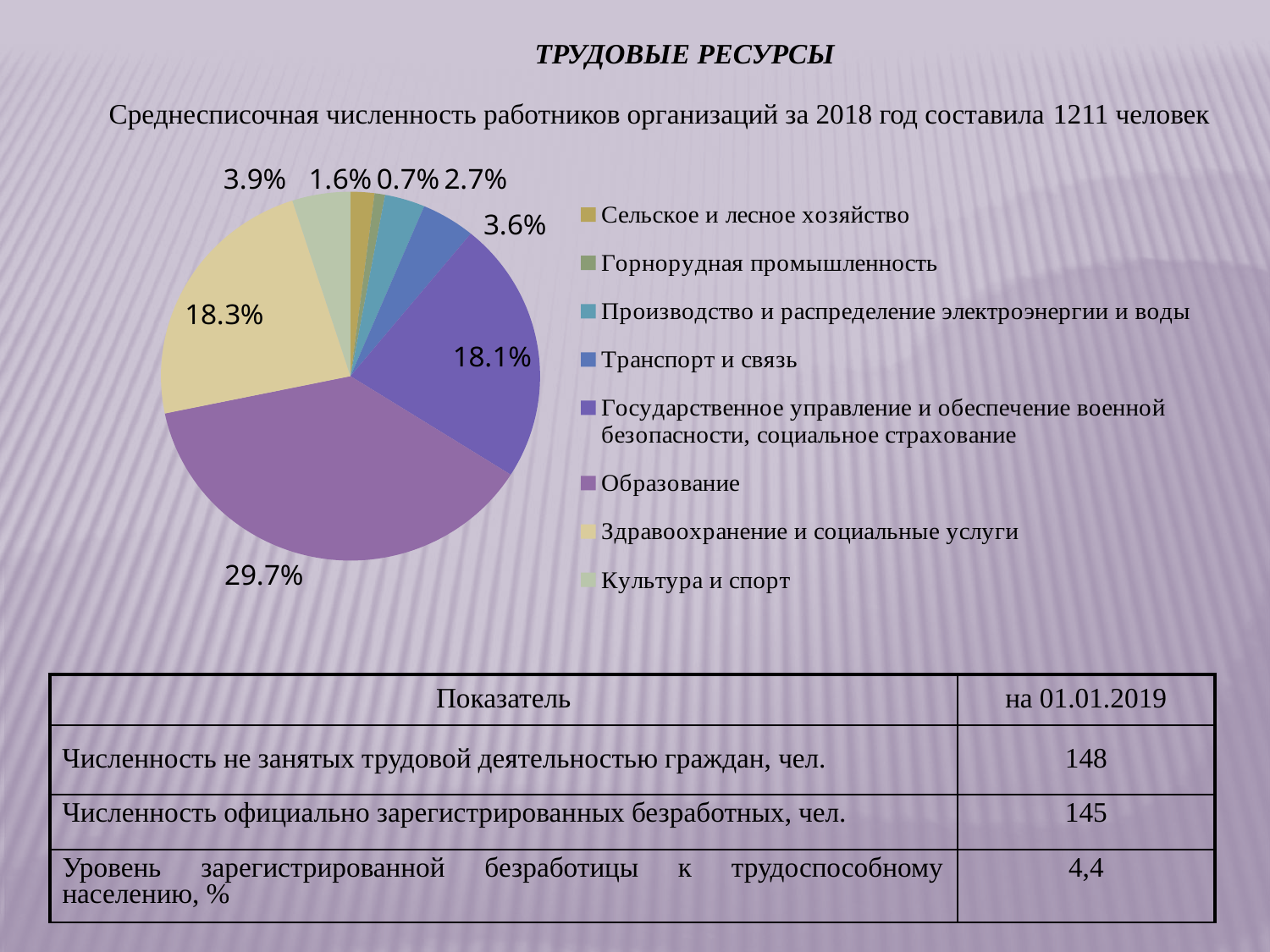
Which has the larger share: Культура и спорт or Сельское и лесное хозяйство? Культура и спорт Which has the larger share: Образование or Государственное управление и обеспечение военной безопасности, социальное страхование? Образование Which category has the smallest share of the pie chart? Горнорудная промышленность Which category has the largest share of the pie chart? Образование How many categories does the legend of the pie chart list? 8 What is the title at the top of the slide? ТРУДОВЫЕ РЕСУРСЫ What is the difference in percentage points between the shares of Образование and Здравоохранение и социальные услуги? 11.4 What kind of chart is shown on the slide? pie chart What share of the pie chart does Здравоохранение и социальные услуги have? 18.3% What share of the pie chart does Образование have? 29.7% What share of the pie chart does Культура и спорт have? 3.9% What share of the pie chart does Транспорт и связь have? 3.6%